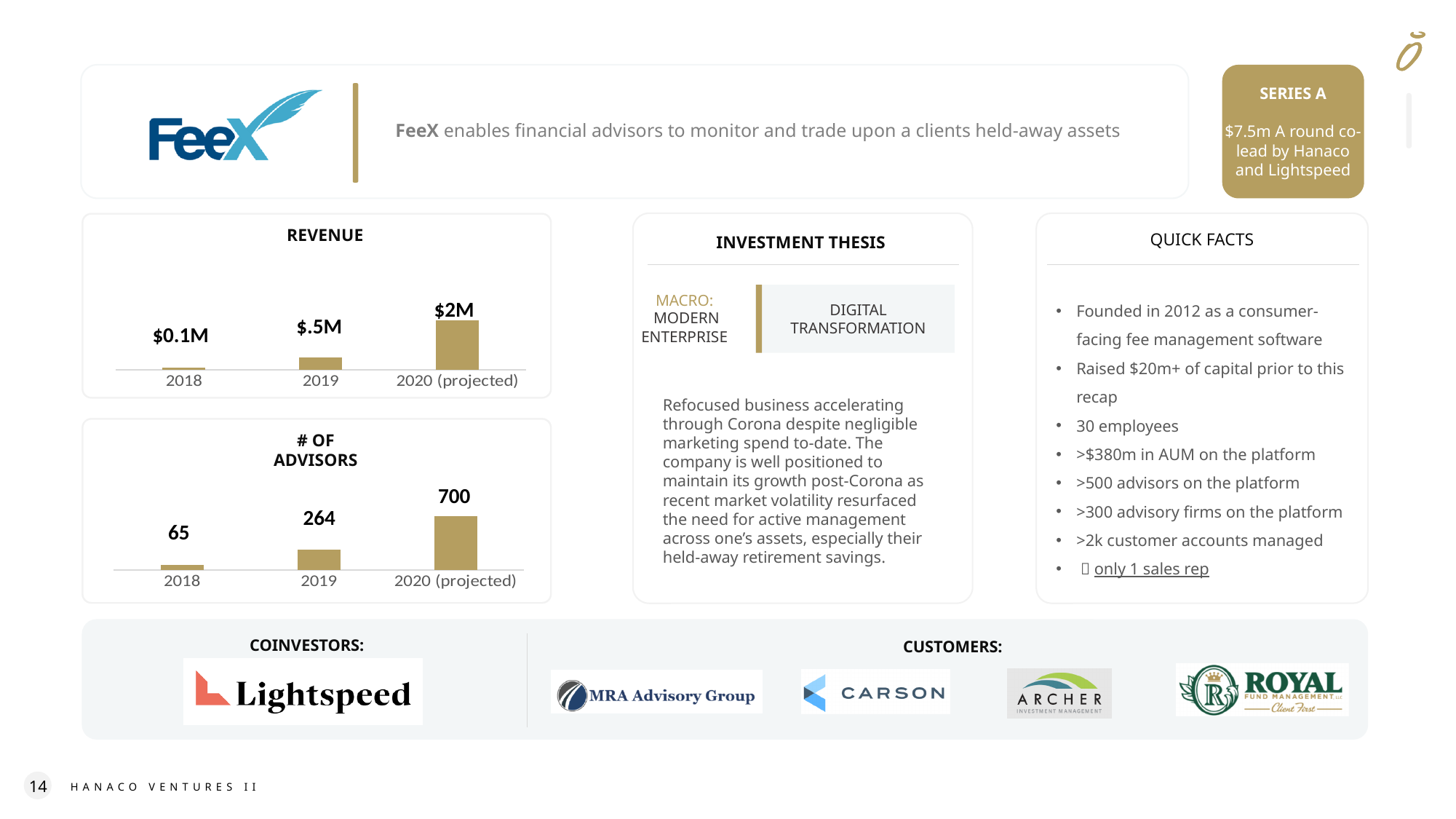
In the REVENUE chart, do the values rise or fall from 2018 to 2020 (projected)? rise In the REVENUE chart, how many years are shown on the x axis? 3 In the REVENUE chart, what is the revenue value for 2019? $.5M In the # OF ADVISORS chart, what is the difference between the 2020 (projected) value and the 2019 value? 436 In the # OF ADVISORS chart, what is the value for 2019? 264 In the # OF ADVISORS chart, which is larger, the value for 2018 or the value for 2019? 2019 In the # OF ADVISORS chart, which year has the highest number of advisors? 2020 (projected) In the # OF ADVISORS chart, what is the value for 2018? 65 In the REVENUE chart, which year has the lowest revenue? 2018 What kind of chart is the # OF ADVISORS chart? bar chart In the REVENUE chart, what is the projected revenue for 2020? $2M What is the title of the chart in the upper left of the slide? REVENUE